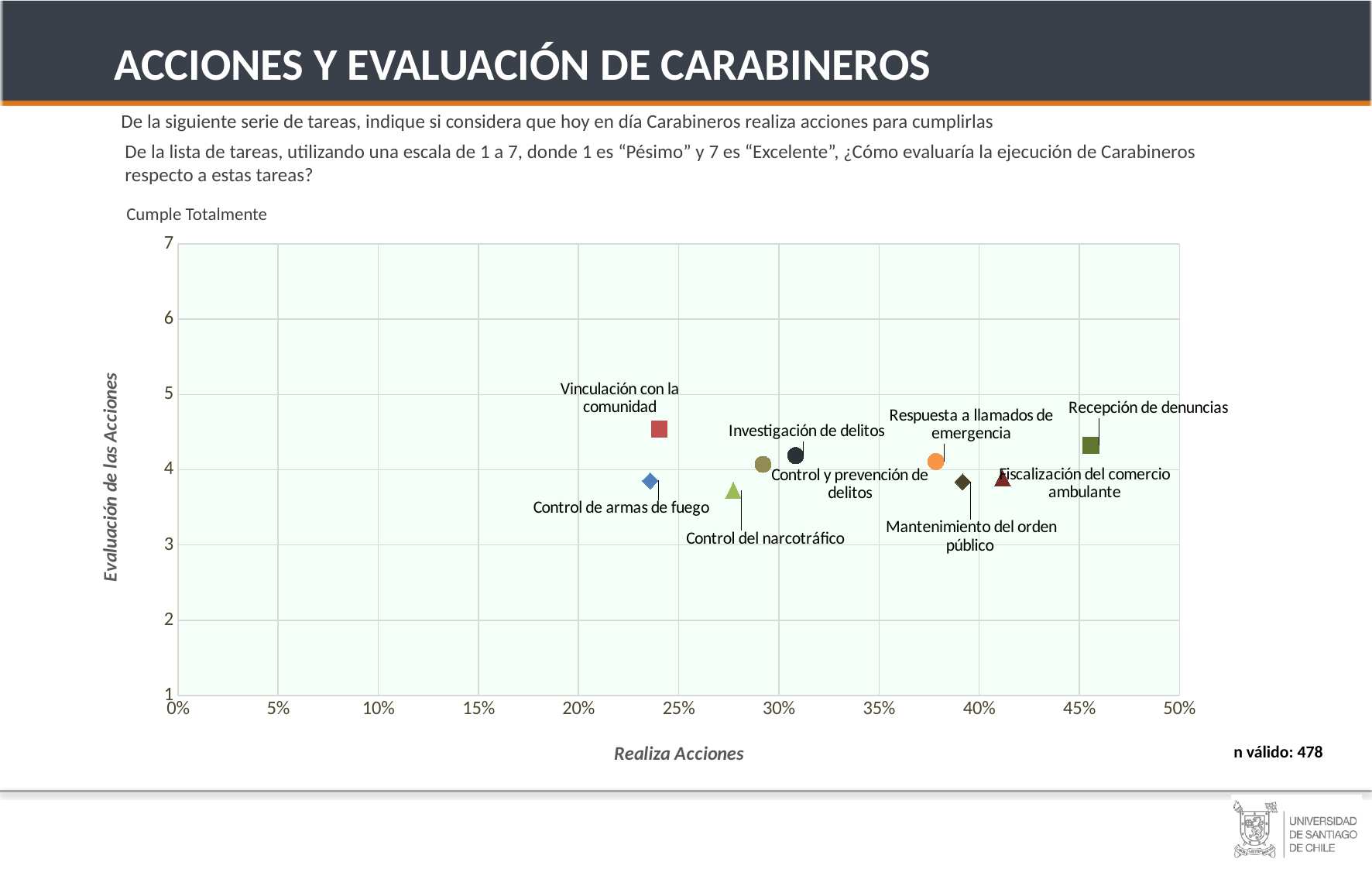
What kind of chart is shown on the slide? scatter chart Is the 'Realiza Acciones' value for Control de armas de fuego greater or less than 25%? less Is the 'Evaluación de las Acciones' value for Vinculación con la comunidad greater or less than 4? greater Is the 'Evaluación de las Acciones' value for Control del narcotráfico greater or less than 4? less What is the title of the horizontal axis of the chart? Realiza Acciones Which task has the highest 'Evaluación de las Acciones' score? Vinculación con la comunidad Which has a higher 'Realiza Acciones' value: Recepción de denuncias or Vinculación con la comunidad? Recepción de denuncias How many tasks (data points) are plotted on the chart? 9 What is the valid sample size (n válido) shown on the slide? 478 Which task has the highest value on the 'Realiza Acciones' axis? Recepción de denuncias